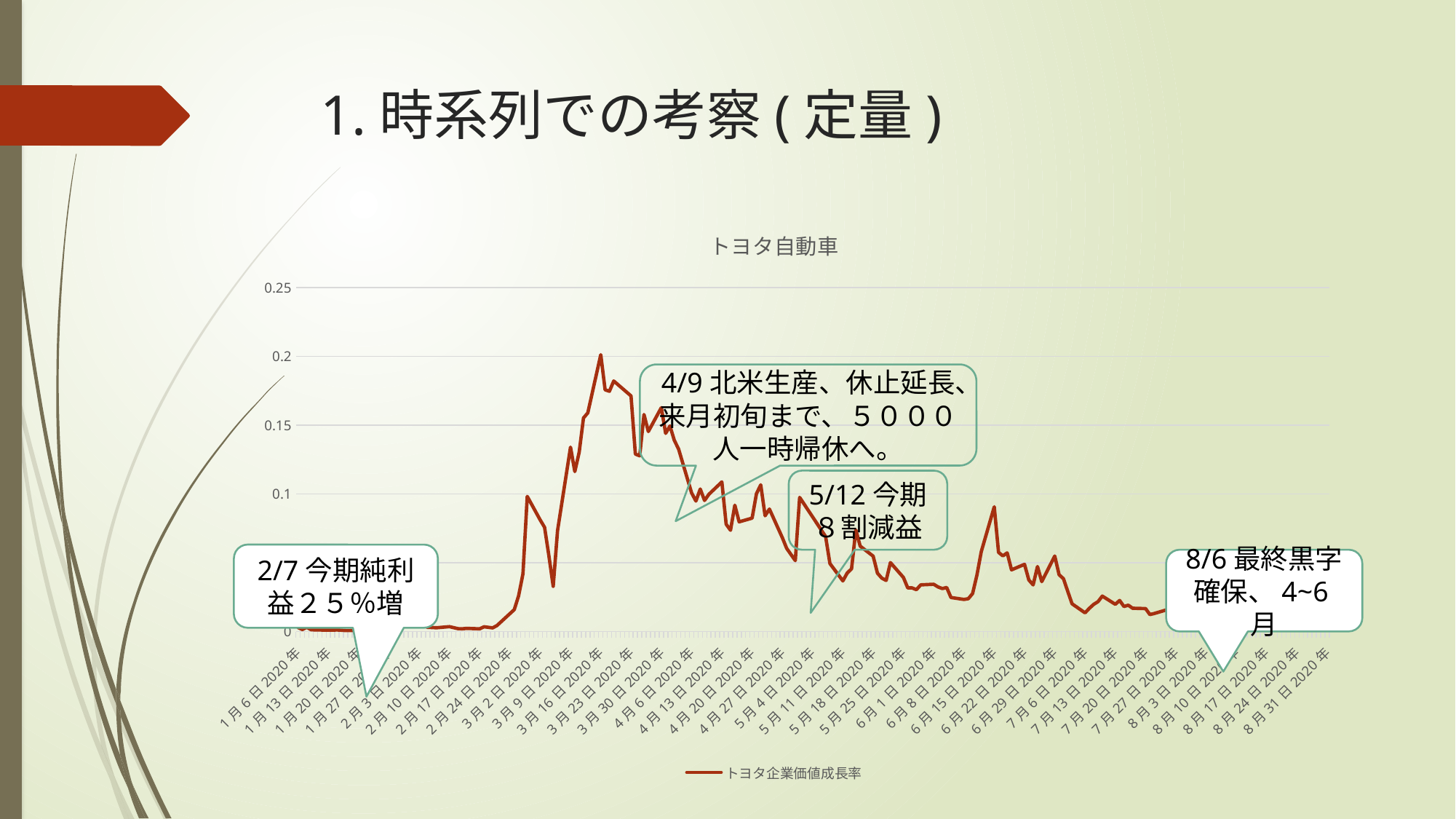
What is the title of the chart? トヨタ自動車 What is the first date label on the horizontal axis? 1月6日2020年 Does the line generally rise or fall from mid-March to August? fall Is the value for 7月20日2020年 greater or less than 0.1? less Which is larger, the value for 3月16日2020年 or the value for 6月15日2020年? 3月16日2020年 Is the peak value of the line in March greater or less than 0.15? greater How many series does the legend list? 1 What is the name of the series shown in the legend? トヨタ企業価値成長率 What kind of chart is shown on the slide? line chart What is the highest value shown on the vertical axis? 0.25 Is the value for 1月6日2020年 greater or less than 0.05? less In which month does the line reach its highest value? 3月